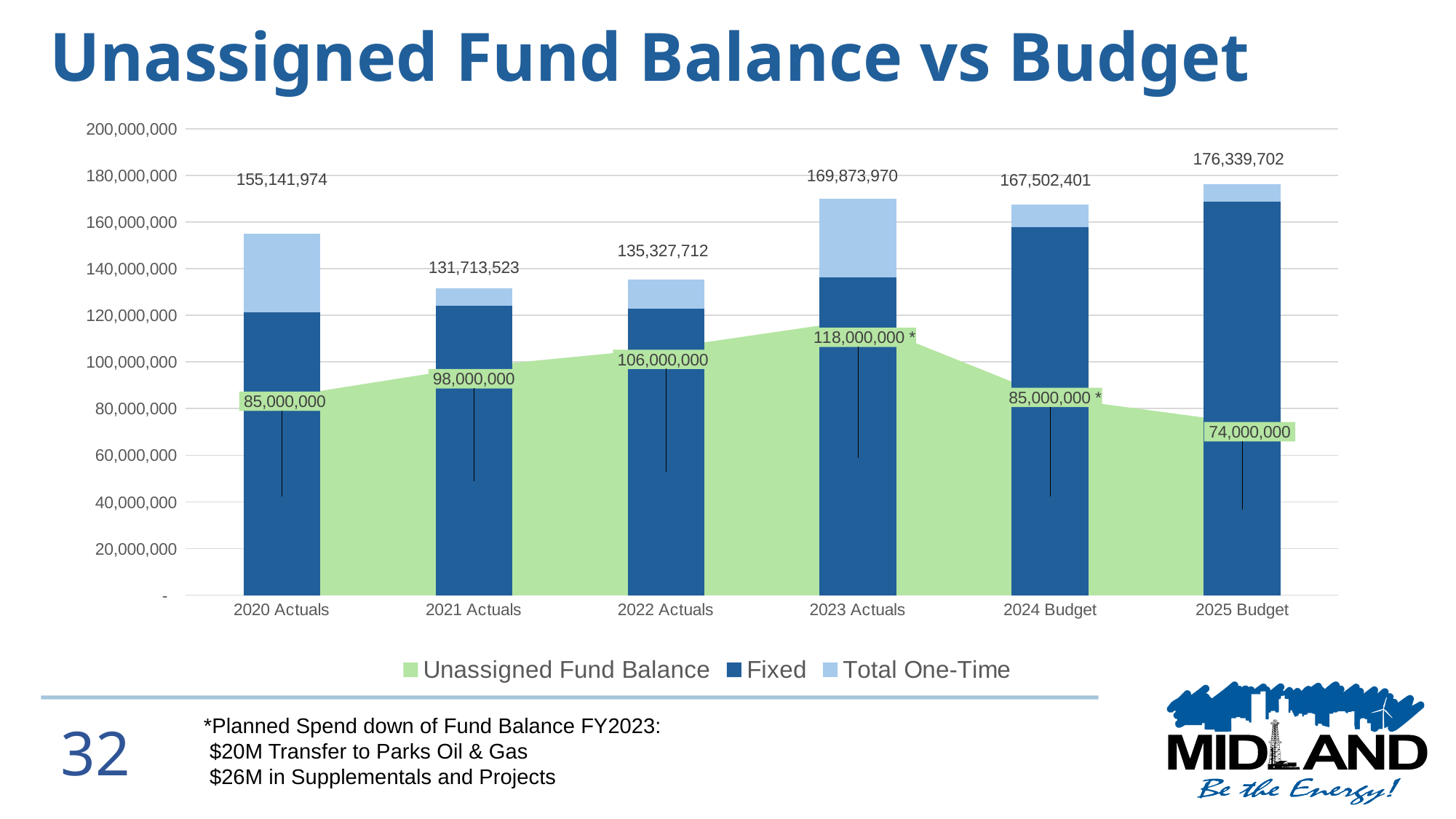
How many categories are shown on the x axis? 6 What is the total bar value for 2020 Actuals? 155,141,974 What is the Unassigned Fund Balance value for 2022 Actuals? 106,000,000 What is the Unassigned Fund Balance value for 2025 Budget? 74,000,000 What is the total bar value for 2024 Budget? 167,502,401 Which category has the lowest total bar value? 2021 Actuals What is the difference between the Unassigned Fund Balance for 2023 Actuals and 2025 Budget? 44,000,000 Which category has the highest Unassigned Fund Balance? 2023 Actuals Which category has the highest total bar value? 2025 Budget Is the Fixed value for 2025 Budget greater or less than 160,000,000? greater How many series does the legend list? 3 What is the difference between the total bar values for 2025 Budget and 2020 Actuals? 21,197,728